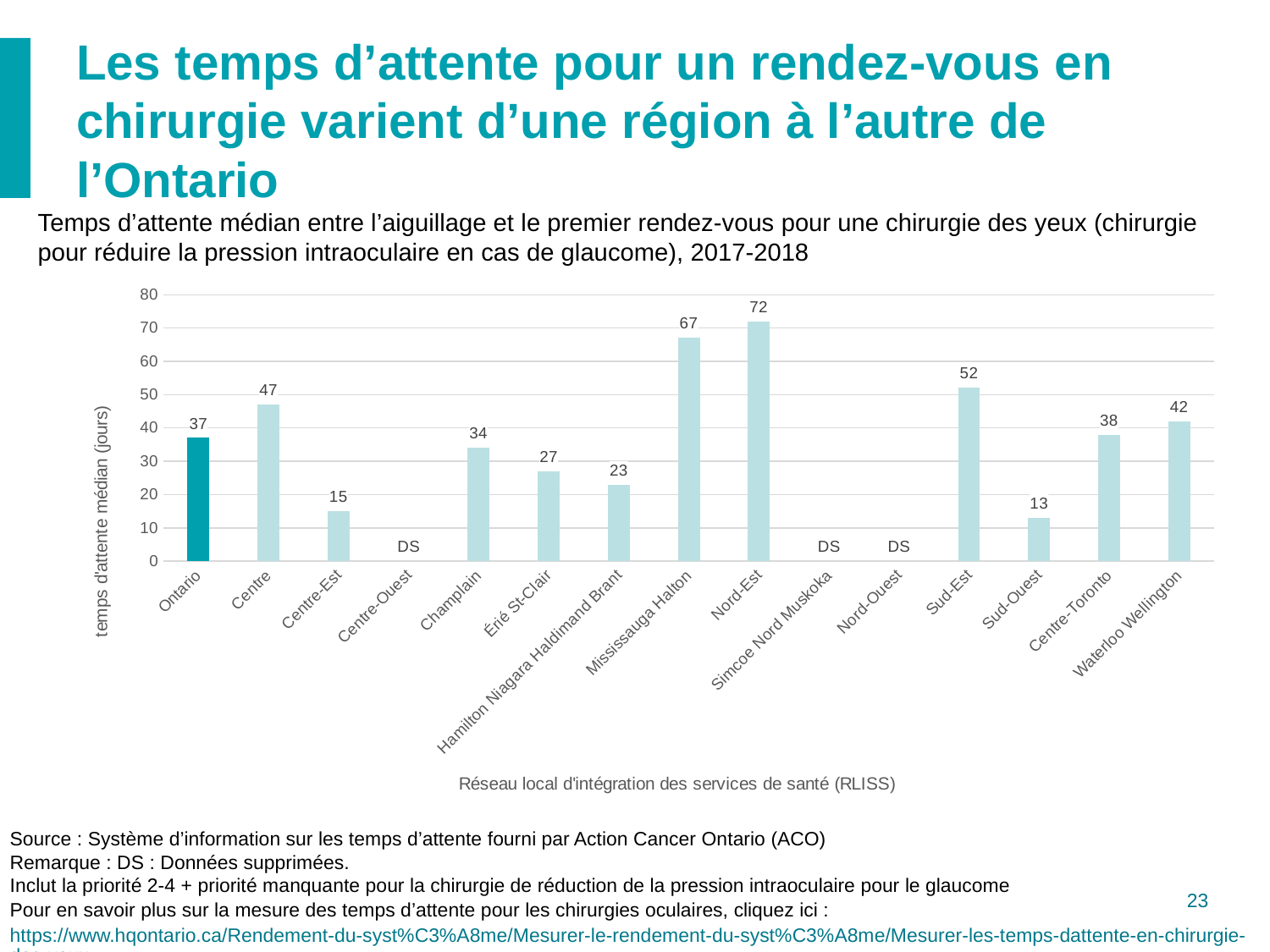
Which is larger, the value for Centre or the value for Waterloo Wellington? Centre Which region has the highest median wait time? Nord-Est How many regions are marked DS (données supprimées) instead of a value? 3 What is the median wait time shown for Sud-Ouest? 13 What value is shown for Ontario? 37 How many categories are shown on the x axis? 15 What is the difference between the values for Mississauga Halton and Champlain? 33 What is the label of the y axis? temps d'attente médian (jours) Is the value for Sud-Est greater or less than 50? greater Among the regions with a numeric value, which has the lowest median wait time? Sud-Ouest What is the median wait time shown for Nord-Est? 72 What kind of chart is shown on the slide? bar chart